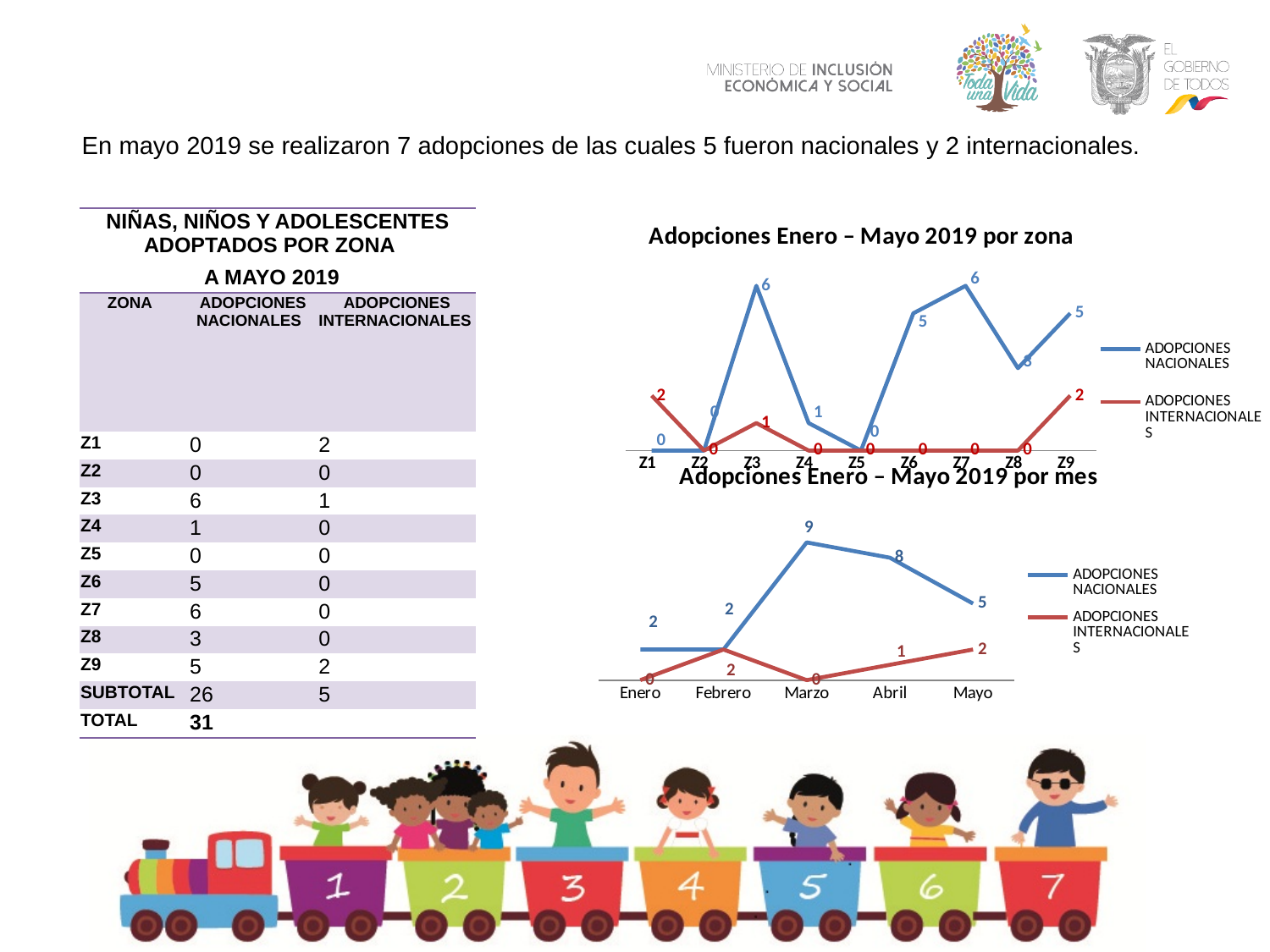
In the chart 'Adopciones Enero – Mayo 2019 por mes', is ADOPCIONES NACIONALES for Abril larger or smaller than for Mayo? larger In the chart 'Adopciones Enero – Mayo 2019 por zona', what is the value of ADOPCIONES INTERNACIONALES for Z9? 2 In the chart 'Adopciones Enero – Mayo 2019 por mes', does ADOPCIONES NACIONALES rise or fall from Marzo to Mayo? fall In the chart 'Adopciones Enero – Mayo 2019 por zona', what is the value of ADOPCIONES NACIONALES for Z3? 6 In the chart 'Adopciones Enero – Mayo 2019 por mes', which month has the highest value of ADOPCIONES NACIONALES? Marzo In the chart 'Adopciones Enero – Mayo 2019 por mes', how many series does the legend list? 2 In the chart 'Adopciones Enero – Mayo 2019 por zona', what is the difference between ADOPCIONES NACIONALES and ADOPCIONES INTERNACIONALES for Z9? 3 In the chart 'Adopciones Enero – Mayo 2019 por zona', which zone has the lowest value of ADOPCIONES NACIONALES among Z3, Z4 and Z6? Z4 In the chart 'Adopciones Enero – Mayo 2019 por zona', how many zones are shown on the x axis? 9 In the chart 'Adopciones Enero – Mayo 2019 por mes', what is the value of ADOPCIONES INTERNACIONALES for Abril? 1 In the chart 'Adopciones Enero – Mayo 2019 por mes', what is the value of ADOPCIONES NACIONALES for Marzo? 9 What type of chart is 'Adopciones Enero – Mayo 2019 por mes'? line chart